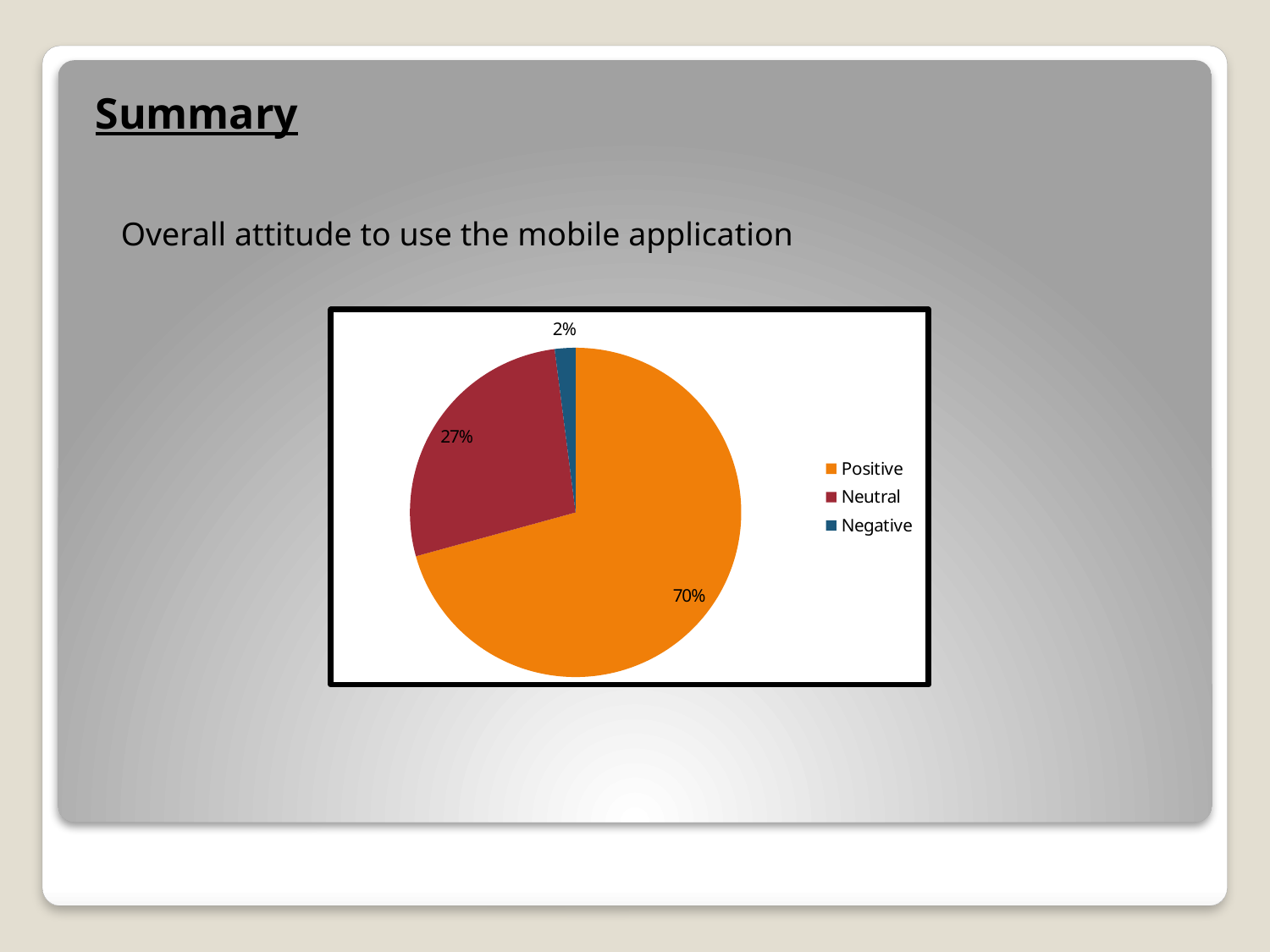
What share of the pie is Negative? 2% Which is larger, the Neutral slice or the Negative slice? Neutral How many categories does the pie chart show? 3 What share of the pie is Positive? 70% Which category has the largest slice of the pie? Positive What kind of chart is shown on the slide? pie chart Which category has the smallest slice of the pie? Negative What is the difference in percentage points between the Neutral and Negative slices? 25 What colour is the Positive slice in the pie chart? orange What share of the pie is Neutral? 27% What are the three entries listed in the chart legend? Positive, Neutral, Negative What is the difference in percentage points between the Positive and Neutral slices? 43